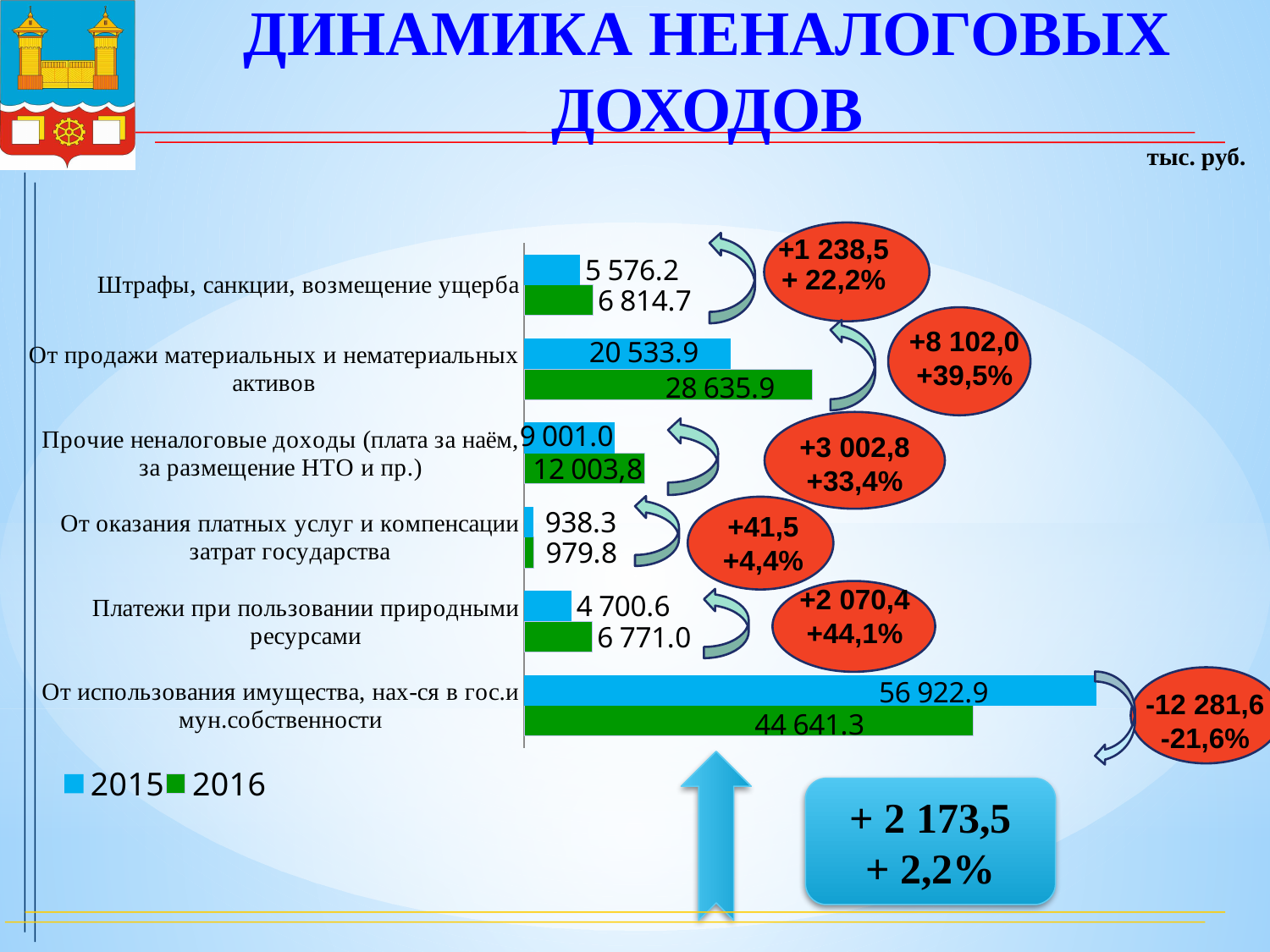
How many series does the chart legend list? 2 Which category has the lowest 2016 value? От оказания платных услуг и компенсации затрат государства What is the 2015 value for 'От оказания платных услуг и компенсации затрат государства'? 938.3 Which colour represents the 2016 series in the chart? green For 'От использования имущества, нах-ся в гос.и мун.собственности', which year has the larger value, 2015 or 2016? 2015 Which category has the highest 2015 value? От использования имущества, нах-ся в гос.и мун.собственности What is the 2015 value for 'Штрафы, санкции, возмещение ущерба'? 5 576.2 How many categories are shown on the chart? 6 What type of chart is shown on the slide? bar chart What is the 2016 value for 'Платежи при пользовании природными ресурсами'? 6 771.0 What is the 2016 value for 'От продажи материальных и нематериальных активов'? 28 635.9 What is the difference between the 2016 and 2015 values for 'Штрафы, санкции, возмещение ущерба'? 1 238.5